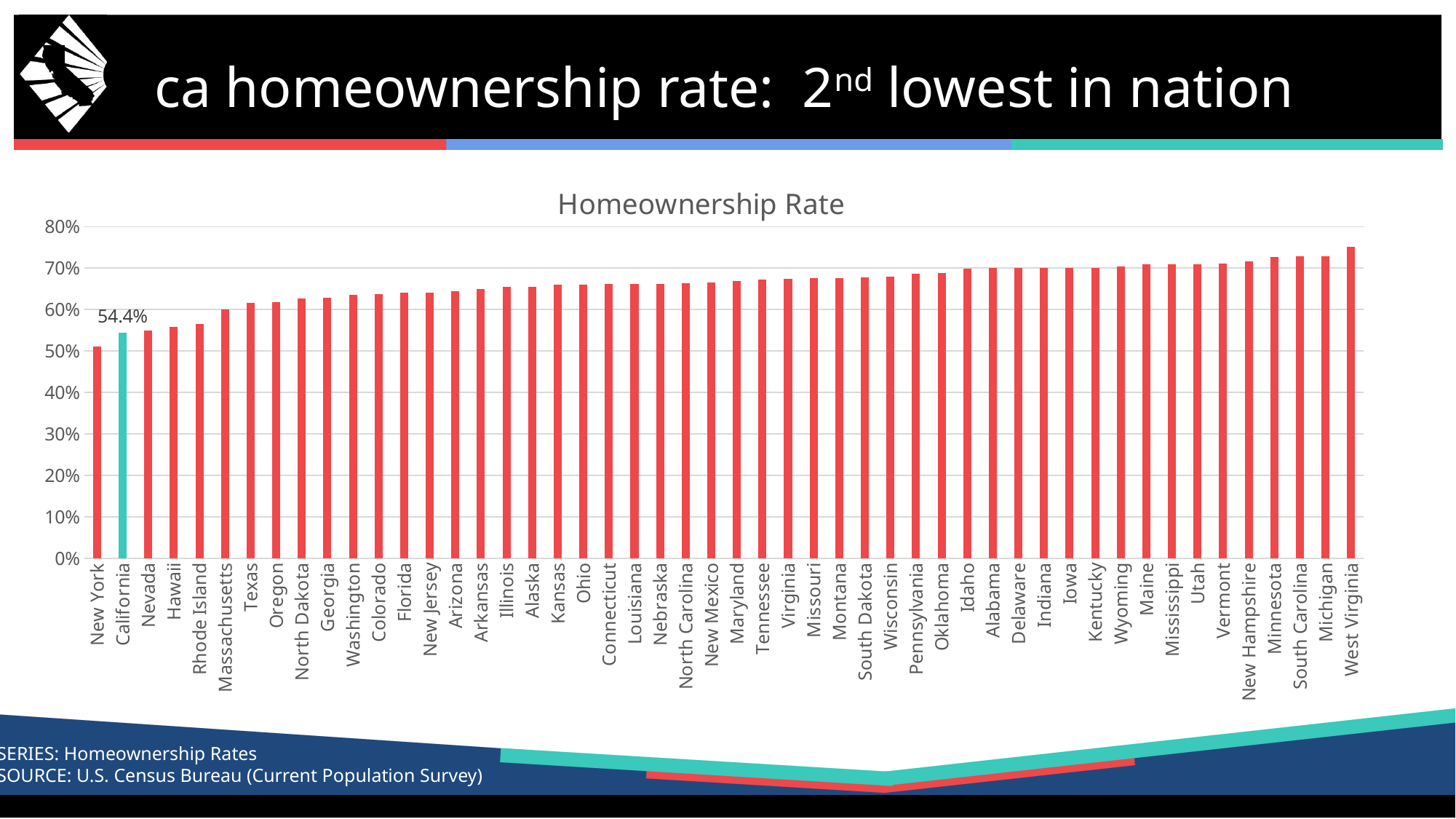
Which state has a higher homeownership rate, Texas or Hawaii? Texas What is the title of the chart? Homeownership Rate Which state has the highest homeownership rate on the chart? West Virginia Is the homeownership rate for West Virginia greater or less than 70%? greater What is the homeownership rate shown for California? 54.4% Is the homeownership rate for Ohio greater or less than 70%? less How many states are plotted on the chart? 50 Is the homeownership rate for Nevada greater or less than 60%? less What kind of chart is shown on the slide? Bar chart Which state has the lowest homeownership rate on the chart? New York Do the homeownership rates rise or fall moving from left to right along the x axis? Rise